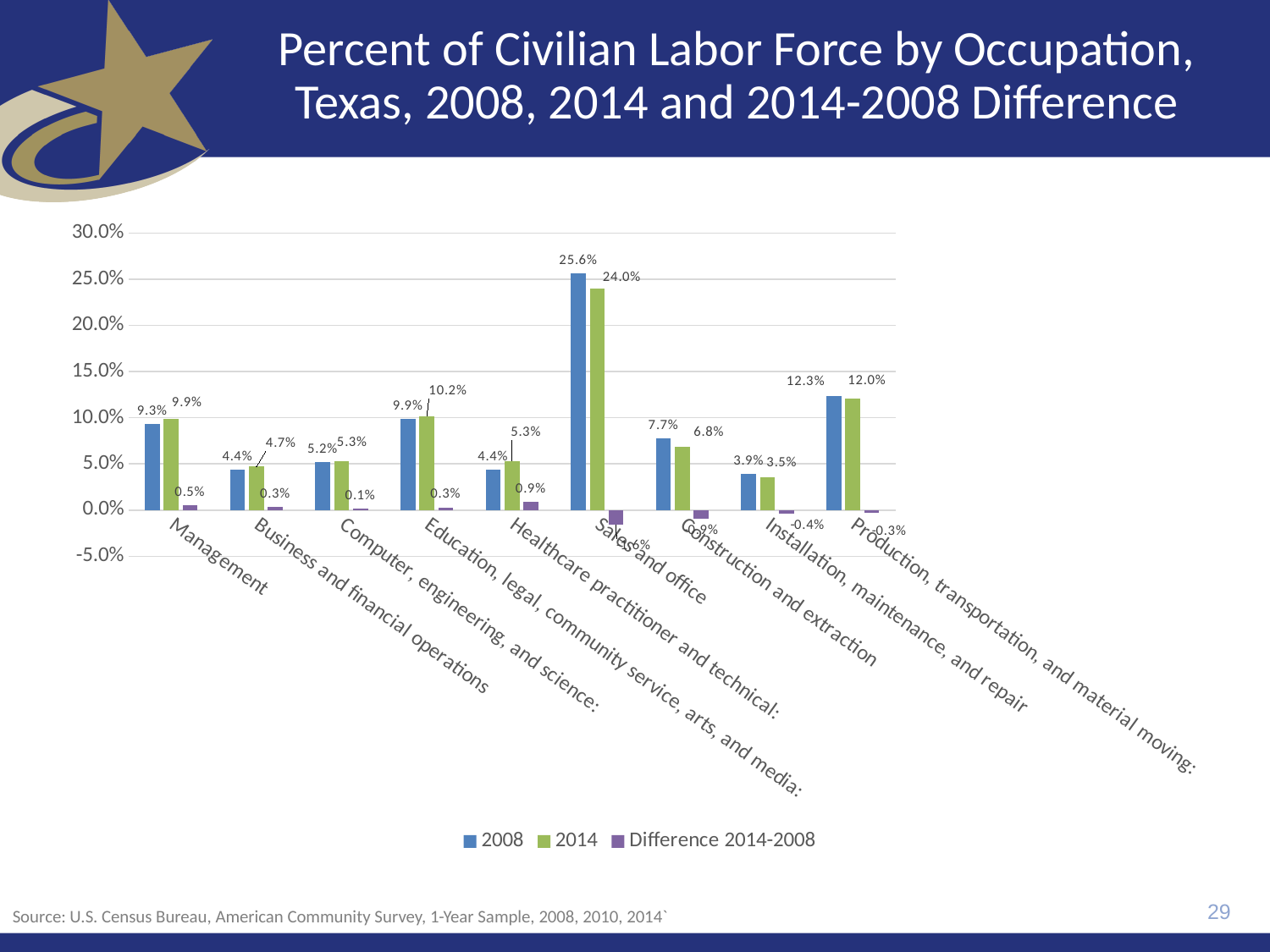
How many occupation categories are shown on the chart? 9 Which occupation had the highest 2008 value? Sales and office What was the 2014 value for Sales and office? 24.0% What is the Difference 2014-2008 value for Healthcare practitioner and technical? 0.9% What was the 2008 value for Management? 9.3% What type of chart is shown on the slide? Bar chart Which is larger for Construction and extraction: the 2008 value or the 2014 value? 2008 What is the difference between the 2008 and 2014 values for Production, transportation, and material moving? 0.3% What was the 2014 value for Installation, maintenance, and repair? 3.5% Which occupation had the lowest 2014 value? Installation, maintenance, and repair Is the 2014 value for Education, legal, community service, arts, and media greater or less than 10.0%? greater How many series does the legend list? 3